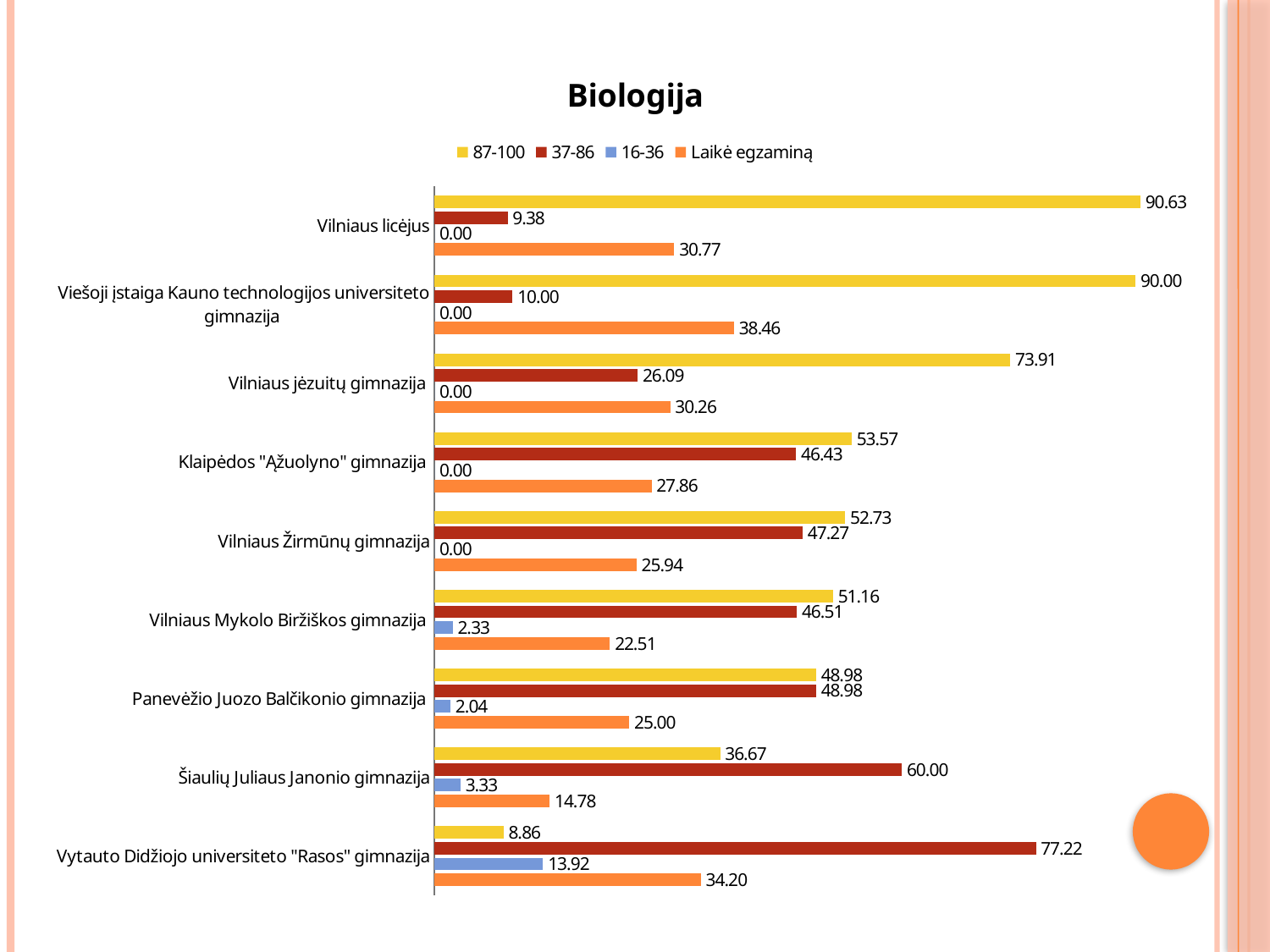
What is the difference between the 87-100 and 37-86 values for Vilniaus jėzuitų gimnazija? 47.82 How many schools are shown on the chart? 9 How many series does the legend list? 4 What is the 16-36 value for Vytauto Didžiojo universiteto "Rasos" gimnazija? 13.92 Which is larger for Klaipėdos "Ąžuolyno" gimnazija: the 87-100 value or the 37-86 value? 87-100 Which school has the lowest Laikė egzaminą value? Šiaulių Juliaus Janonio gimnazija What kind of chart is shown on the slide? Bar chart What is the Laikė egzaminą value for Viešoji įstaiga Kauno technologijos universiteto gimnazija? 38.46 What is the title of the chart? Biologija What is the 37-86 value for Šiaulių Juliaus Janonio gimnazija? 60.00 What is the 87-100 value for Vilniaus licėjus? 90.63 Which school has the highest 87-100 value? Vilniaus licėjus